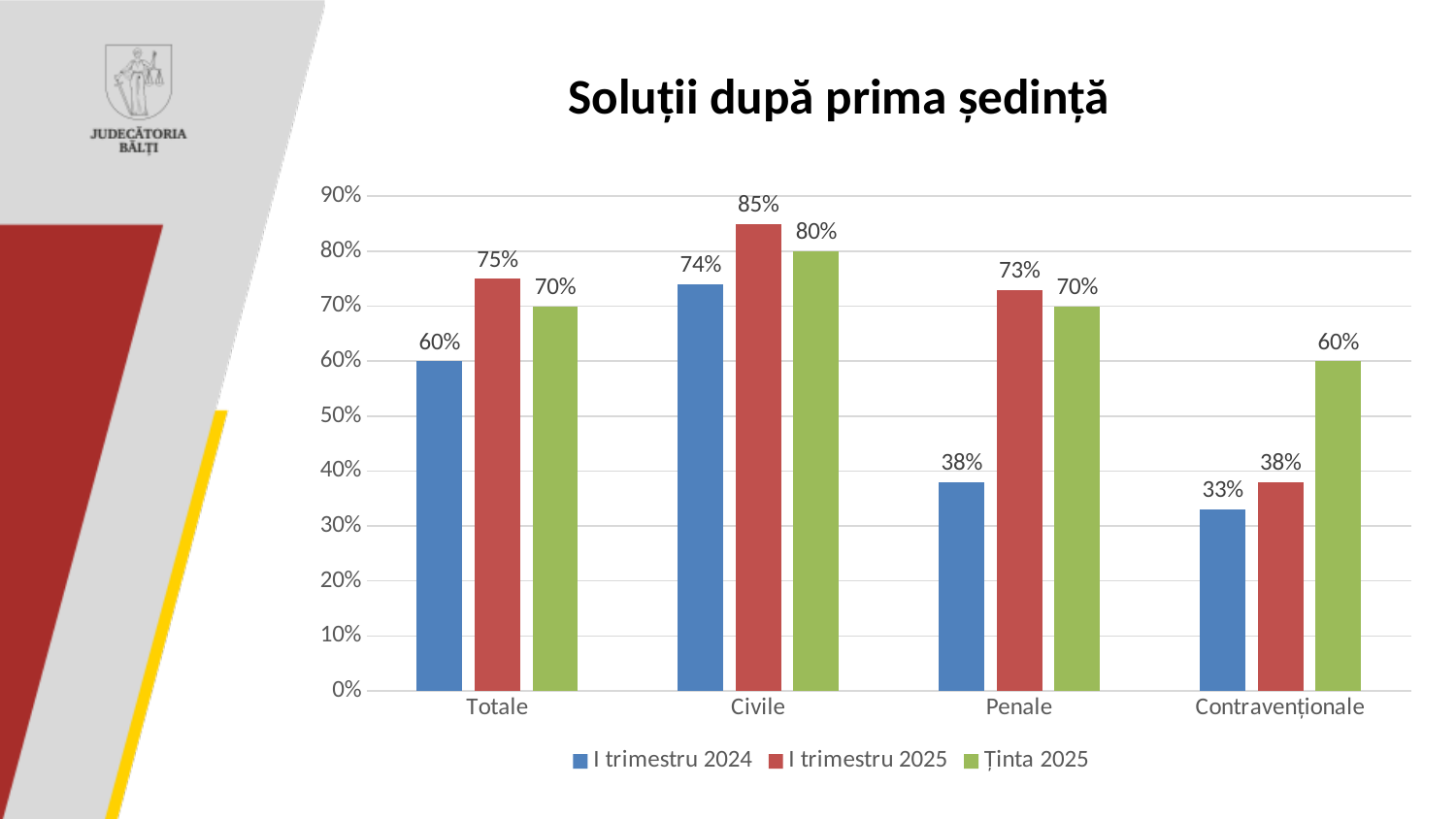
How many series does the legend list? 3 What is the Ținta 2025 value for Contravenționale? 60% What kind of chart is shown on the slide? Bar chart What is the difference between the Ținta 2025 value and the I trimestru 2025 value for Contravenționale? 22% What is the title of the chart? Soluții după prima ședință Which is larger for Penale: the I trimestru 2025 value or the Ținta 2025 value? I trimestru 2025 What is the difference between the I trimestru 2025 and I trimestru 2024 values for Totale? 15% Which category has the highest I trimestru 2025 value? Civile What is the I trimestru 2024 value for Penale? 38% How many categories are shown on the x axis? 4 Which category has the lowest I trimestru 2024 value? Contravenționale What is the value for Civile in the I trimestru 2025 series? 85%